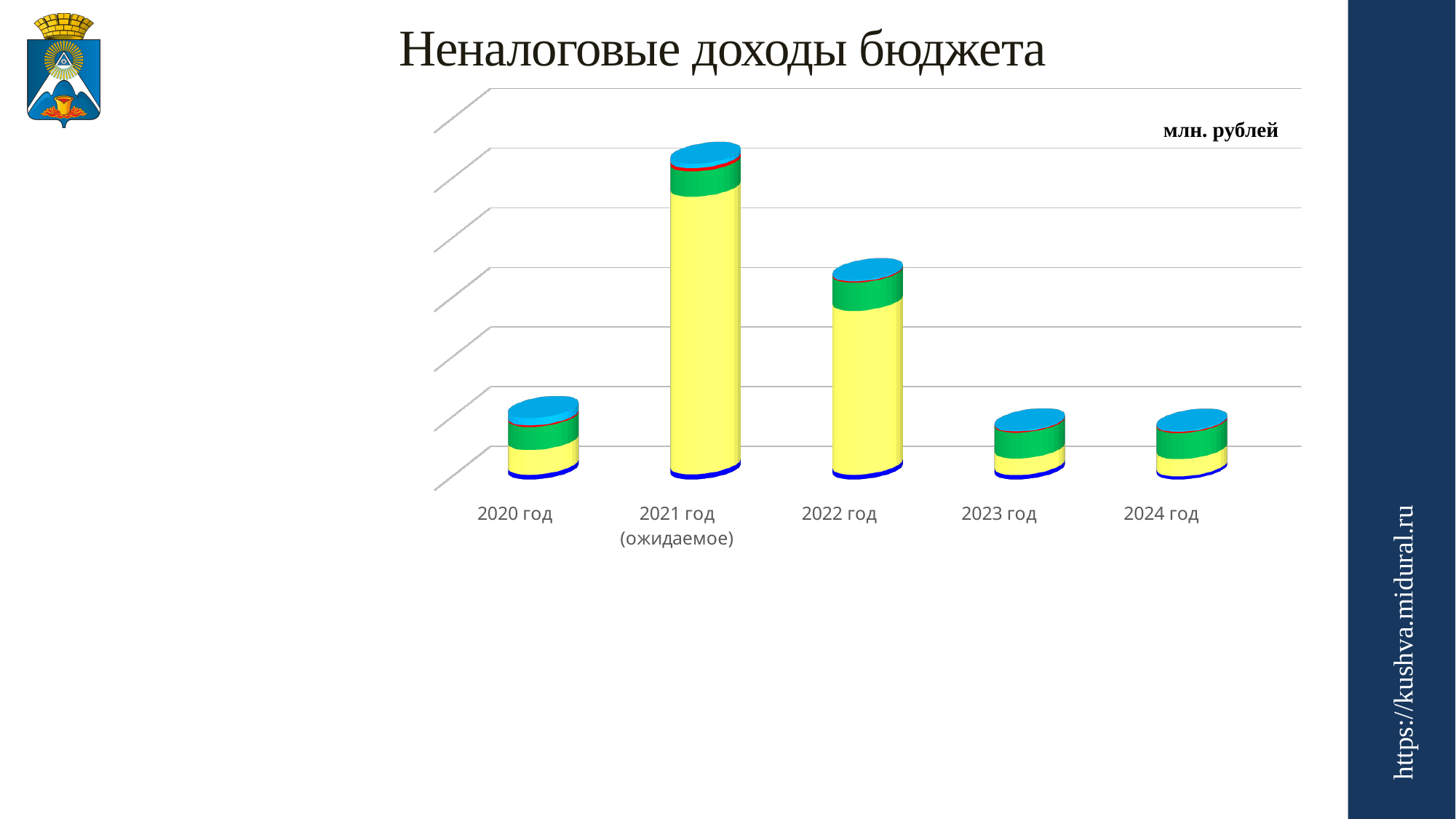
In what units are the chart values given, according to the label on the slide? млн. рублей Which bar is taller, 2020 год or 2023 год? 2020 год Which bar is taller, 2021 год (ожидаемое) or 2022 год? 2021 год (ожидаемое) What kind of chart is shown on the slide? bar chart Does the total value rise or fall from 2021 год (ожидаемое) to 2022 год? fall Does the total value rise or fall from 2020 год to 2021 год (ожидаемое)? rise What is the title of the chart? Неналоговые доходы бюджета Which bar is taller, 2020 год or 2022 год? 2022 год How many categories (years) are shown on the x axis of the chart? 5 Which year has the tallest bar in the chart? 2021 год (ожидаемое)